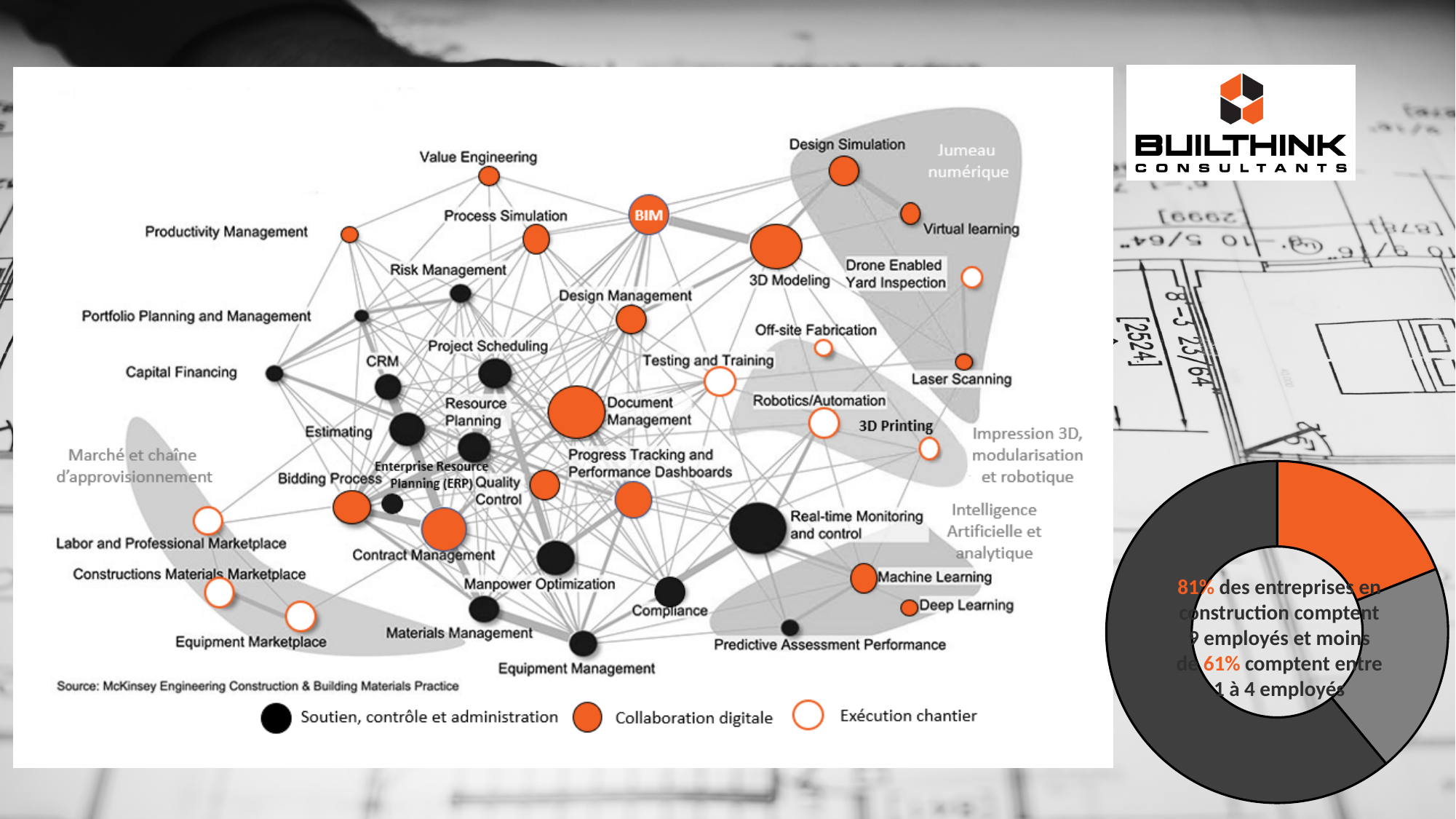
How many slices does the doughnut chart on the right have? 3 What source is cited for the network diagram on the left? McKinsey Engineering Construction & Building Materials Practice In the doughnut chart on the right, is the orange slice larger or smaller than the dark grey slice? smaller What kind of chart is shown on the right side of the slide? doughnut chart In the network diagram on the left, which colour represents 'Collaboration digitale'? orange According to the text in the centre of the doughnut chart, what percentage of companies have between 1 and 4 employees? 61% In the doughnut chart on the right, which colour slice is the largest? dark grey According to the text in the centre of the doughnut chart, what percentage of construction companies have 9 employees or fewer? 81% How many categories does the legend of the network diagram on the left list? 3